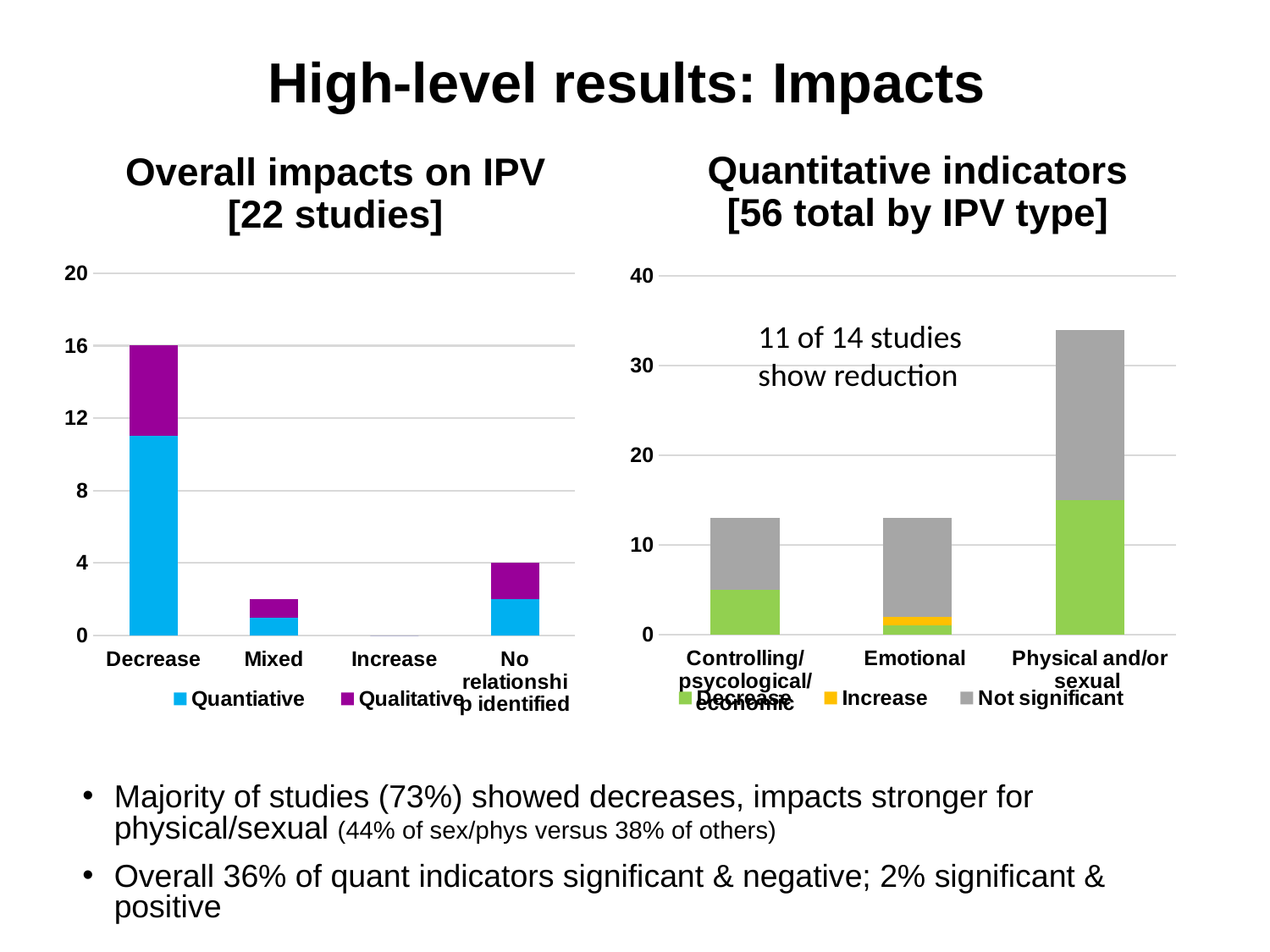
In the 'Overall impacts on IPV [22 studies]' chart, what is the total for 'No relationship identified'? 4 In the 'Quantitative indicators [56 total by IPV type]' chart, is the total for 'Controlling/psychological/economic' greater or less than 20? less In the 'Overall impacts on IPV [22 studies]' chart, what is the difference between the Decrease total and the 'No relationship identified' total? 12 In the 'Overall impacts on IPV [22 studies]' chart, what is the total height of the Decrease bar? 16 In the 'Overall impacts on IPV [22 studies]' chart, which category has the tallest bar? Decrease In the 'Overall impacts on IPV [22 studies]' chart, which category has the lowest value? Increase In the 'Quantitative indicators [56 total by IPV type]' chart, which IPV type has the tallest bar? Physical and/or sexual In the 'Overall impacts on IPV [22 studies]' chart, how many series does the legend list? 2 What kind of chart is the 'Quantitative indicators [56 total by IPV type]' chart? Stacked bar chart In the 'Quantitative indicators [56 total by IPV type]' chart, how many series does the legend list? 3 In the 'Quantitative indicators [56 total by IPV type]' chart, is the total for 'Physical and/or sexual' greater or less than 30? greater In the 'Overall impacts on IPV [22 studies]' chart, how many categories are shown on the x axis? 4